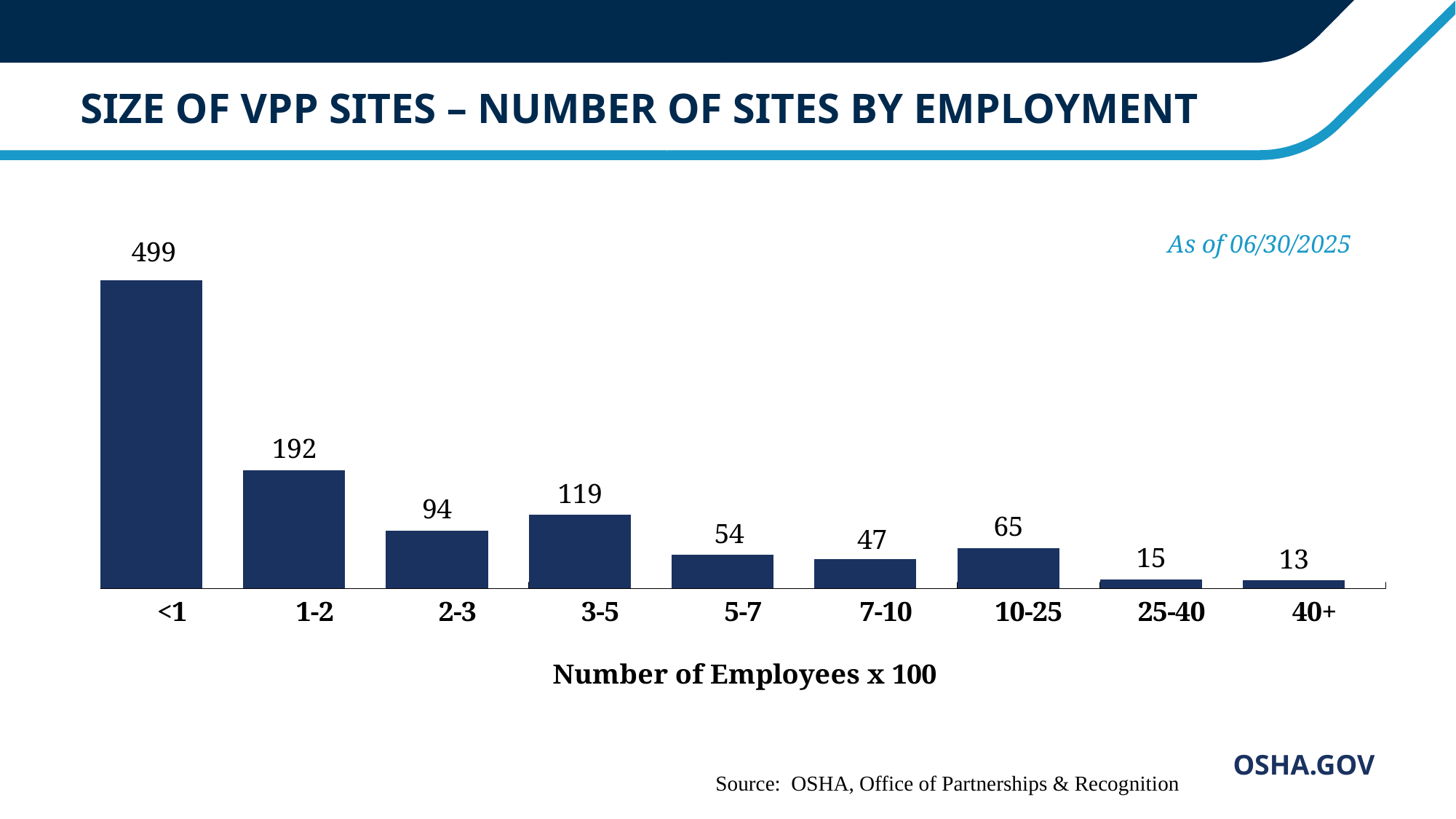
Which category has more sites, 5-7 or 7-10? 5-7 Which category has more sites, 10-25 or 2-3? 2-3 What is the number of sites for the 10-25 category? 65 What is the difference between the number of sites in the <1 category and the 1-2 category? 307 What is the difference between the number of sites in the 3-5 category and the 2-3 category? 25 How many employment categories are shown on the chart? 9 Which employment category has the lowest number of sites? 40+ What is the x-axis label of the chart? Number of Employees x 100 What is the number of sites for the 3-5 category? 119 What type of chart is shown on the slide? Bar chart How many VPP sites are in the <1 employment category (Number of Employees x 100)? 499 Which employment category has the highest number of sites? <1